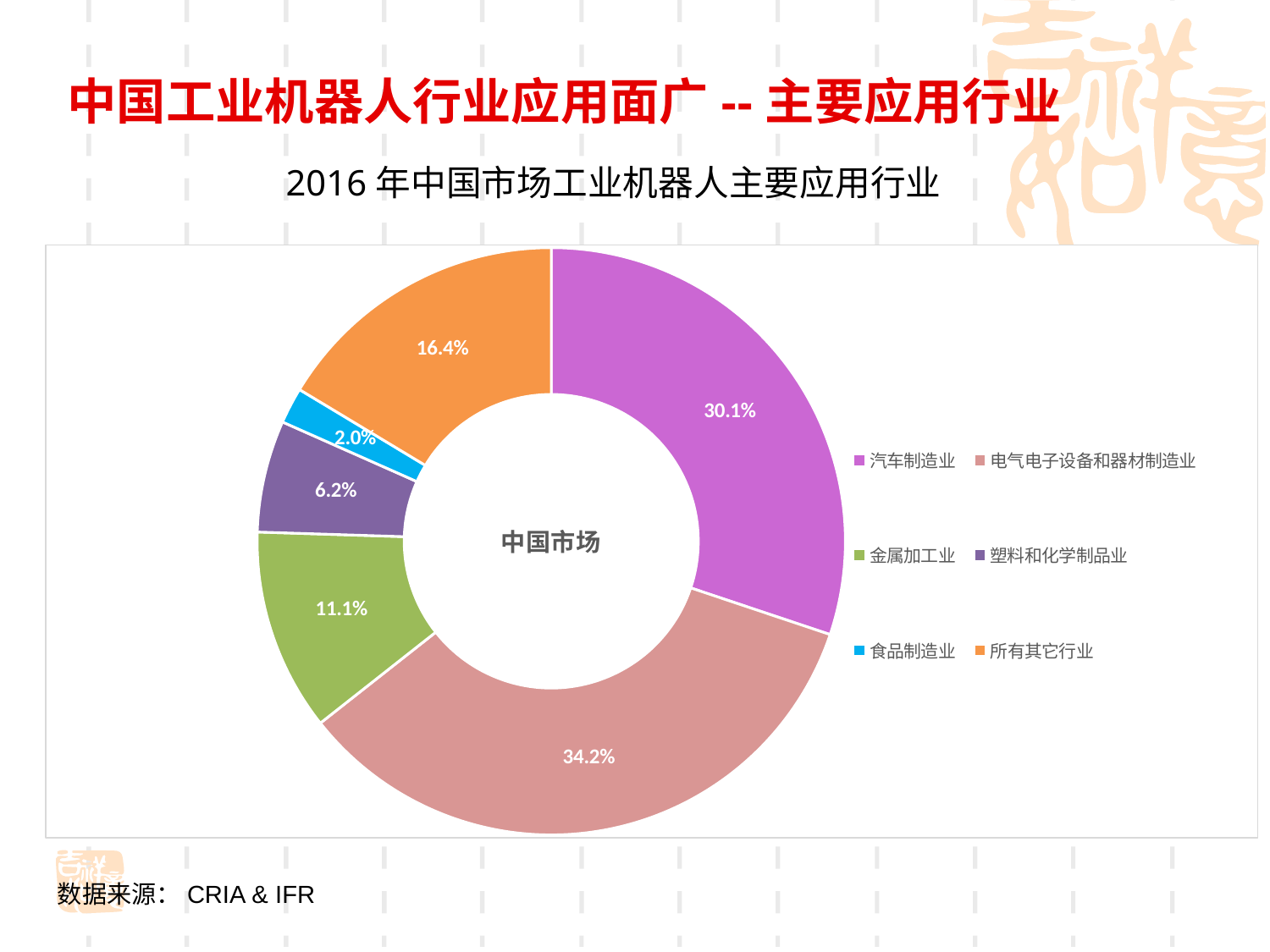
What is the difference between the shares of 电气电子设备和器材制造业 and 汽车制造业? 4.1% What share of the chart does 电气电子设备和器材制造业 account for? 34.2% What kind of chart is shown on the slide? Doughnut (pie) chart Which is larger, the share of 所有其它行业 or the share of 金属加工业? 所有其它行业 What is the difference between the shares of 塑料和化学制品业 and 食品制造业? 4.2% What text is shown in the centre of the doughnut chart? 中国市场 What is the value shown for 汽车制造业? 30.1% Which industry has the smallest share in the chart? 食品制造业 What percentage is shown for 金属加工业? 11.1% How many industry categories are shown in the chart? 6 What is the value for 食品制造业? 2.0% Which industry has the largest share in the chart? 电气电子设备和器材制造业